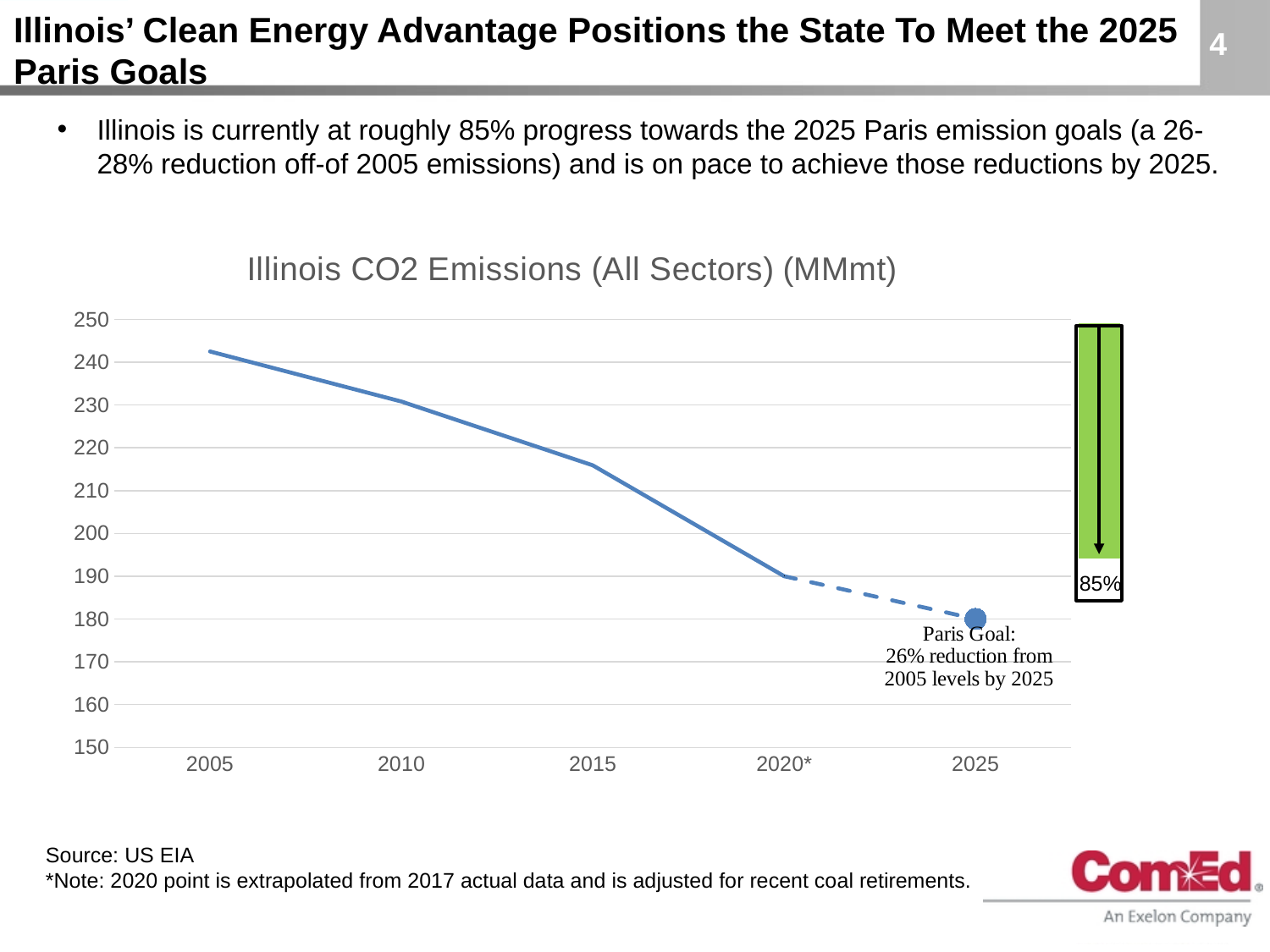
Which is larger, the value for 2010 or the value for 2020*? 2010 Is the value for 2020* greater or less than 200? less Is the value for 2025 greater or less than 190? less Is the value for 2015 greater or less than 220? less What kind of chart is shown on the slide? line chart What percentage is printed in the green progress bar to the right of the chart? 85% How many years are labelled on the x axis of the chart? 5 Which year has the highest CO2 emissions value on the chart? 2005 What is the title of the chart? Illinois CO2 Emissions (All Sectors) (MMmt) Which year has the lowest CO2 emissions value on the chart? 2025 Do the CO2 emissions rise or fall from 2005 to 2025 along the x axis? fall